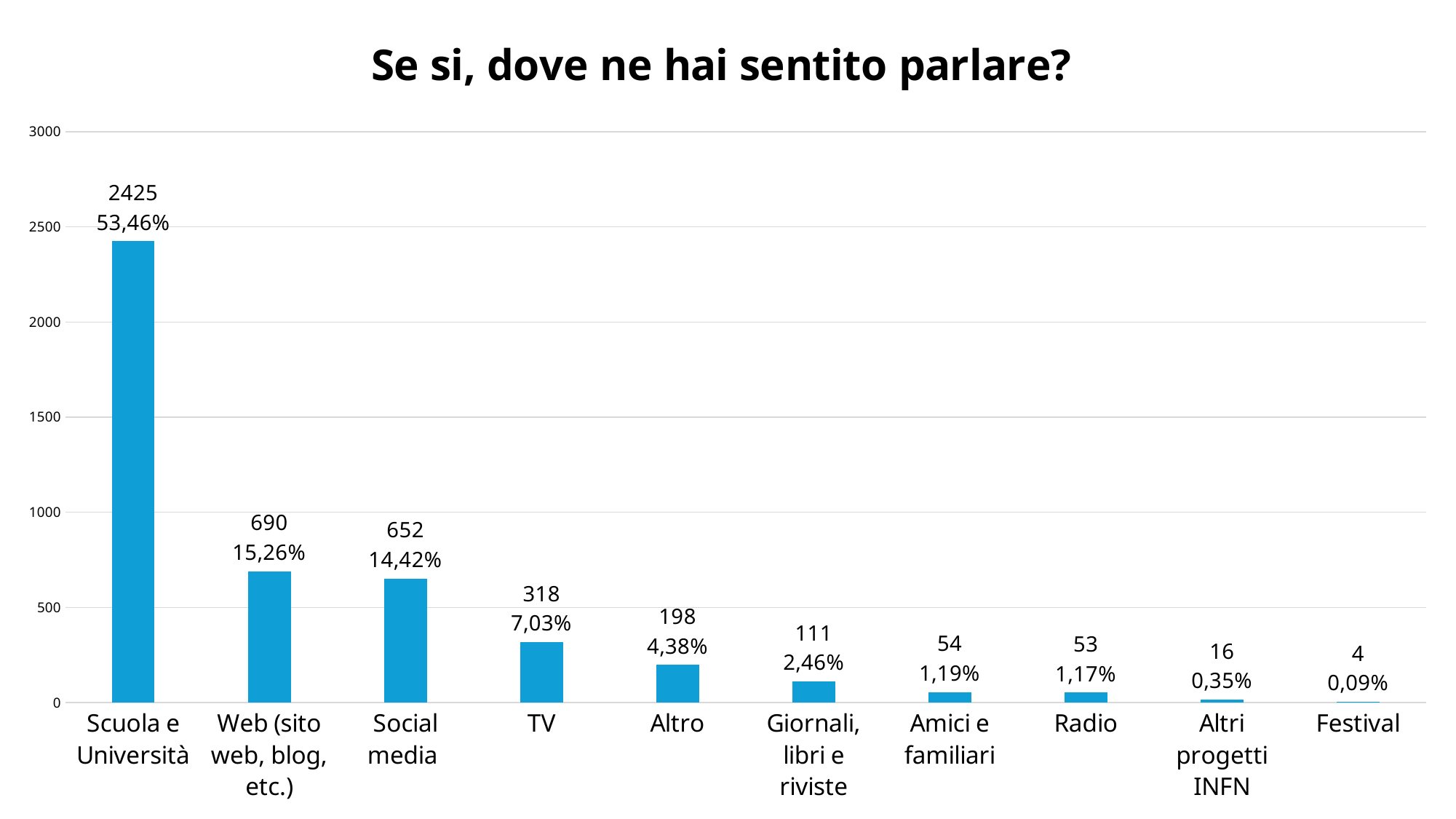
What percentage is shown for Social media? 14,42% Is the value for Scuola e Università greater or less than 2000? greater What is the value for Scuola e Università? 2425 What percentage is shown for Radio? 1,17% How many categories are shown on the x axis? 10 Which category has the highest value? Scuola e Università What is the difference between the values for Web (sito web, blog, etc.) and Social media? 38 Which is larger, the value for Altro or the value for Giornali, libri e riviste? Altro What kind of chart is shown on the slide? bar chart What is the title of the chart? Se si, dove ne hai sentito parlare? What is the value for TV? 318 Which category has the lowest value? Festival